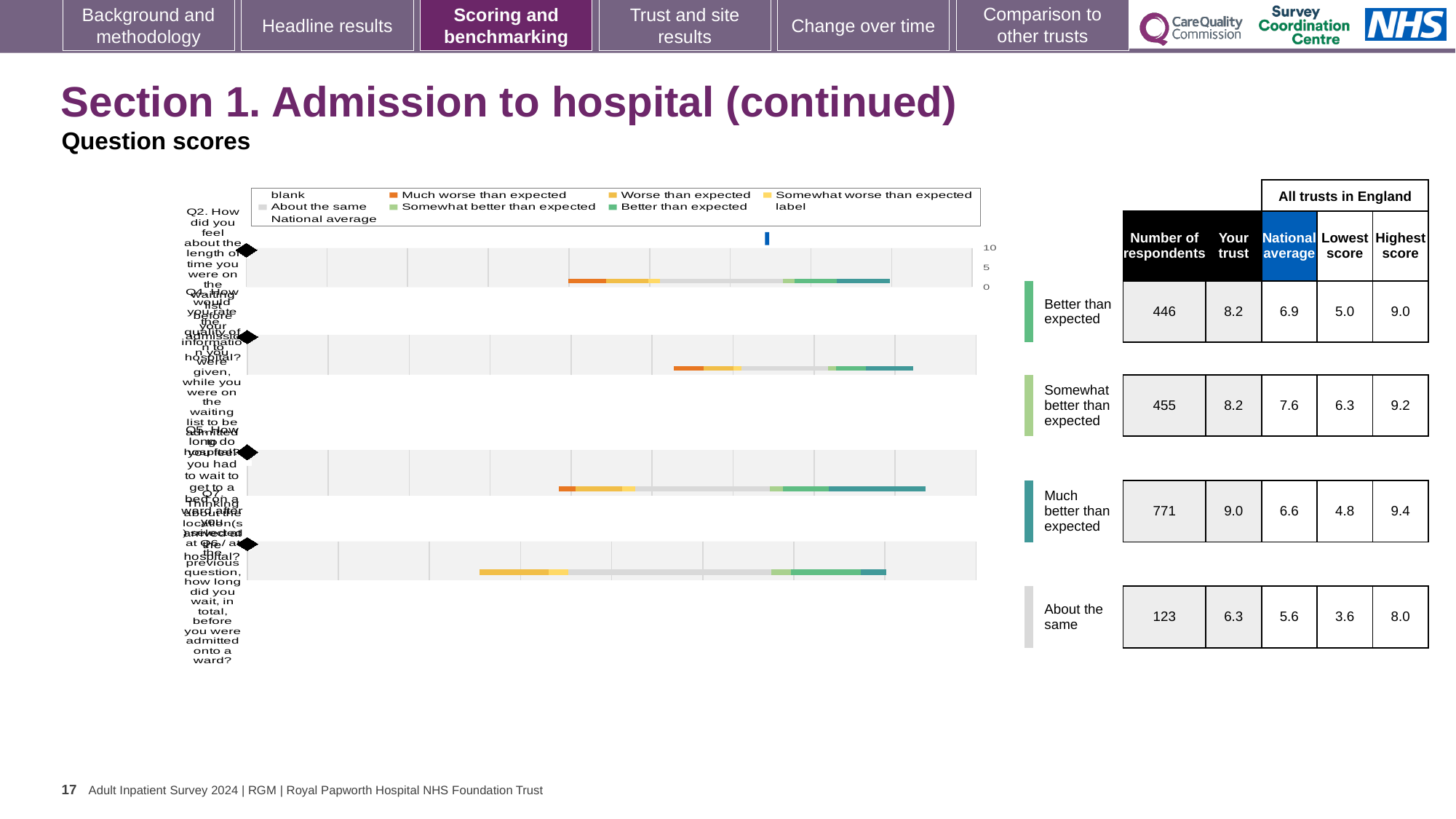
In the table beside the chart, what is the 'Lowest score' for the row labelled 'Better than expected'? 5.0 In the table beside the chart, which has the larger 'Highest score': the row labelled 'Somewhat better than expected' or the row labelled 'Much better than expected'? Much better than expected How many horizontal bars are plotted in the chart? 4 In the table beside the chart, what is the 'Your trust' score for the row labelled 'About the same'? 6.3 In the chart legend, what colour represents 'About the same'? grey What heading spans the Lowest score and Highest score columns in the table beside the chart? All trusts in England In the table beside the chart, which row has the highest 'Your trust' score? Much better than expected In the table beside the chart, which row has the lowest value in the 'Lowest score' column? About the same In the table beside the chart, what is the number of respondents for the row labelled 'Much better than expected'? 771 In the table beside the chart, what is the difference between the 'Your trust' score and the national average for the row labelled 'Much better than expected'? 2.4 What kind of chart is shown on the slide? bar chart In the table beside the chart, what is the national average for the row labelled 'Somewhat better than expected'? 7.6